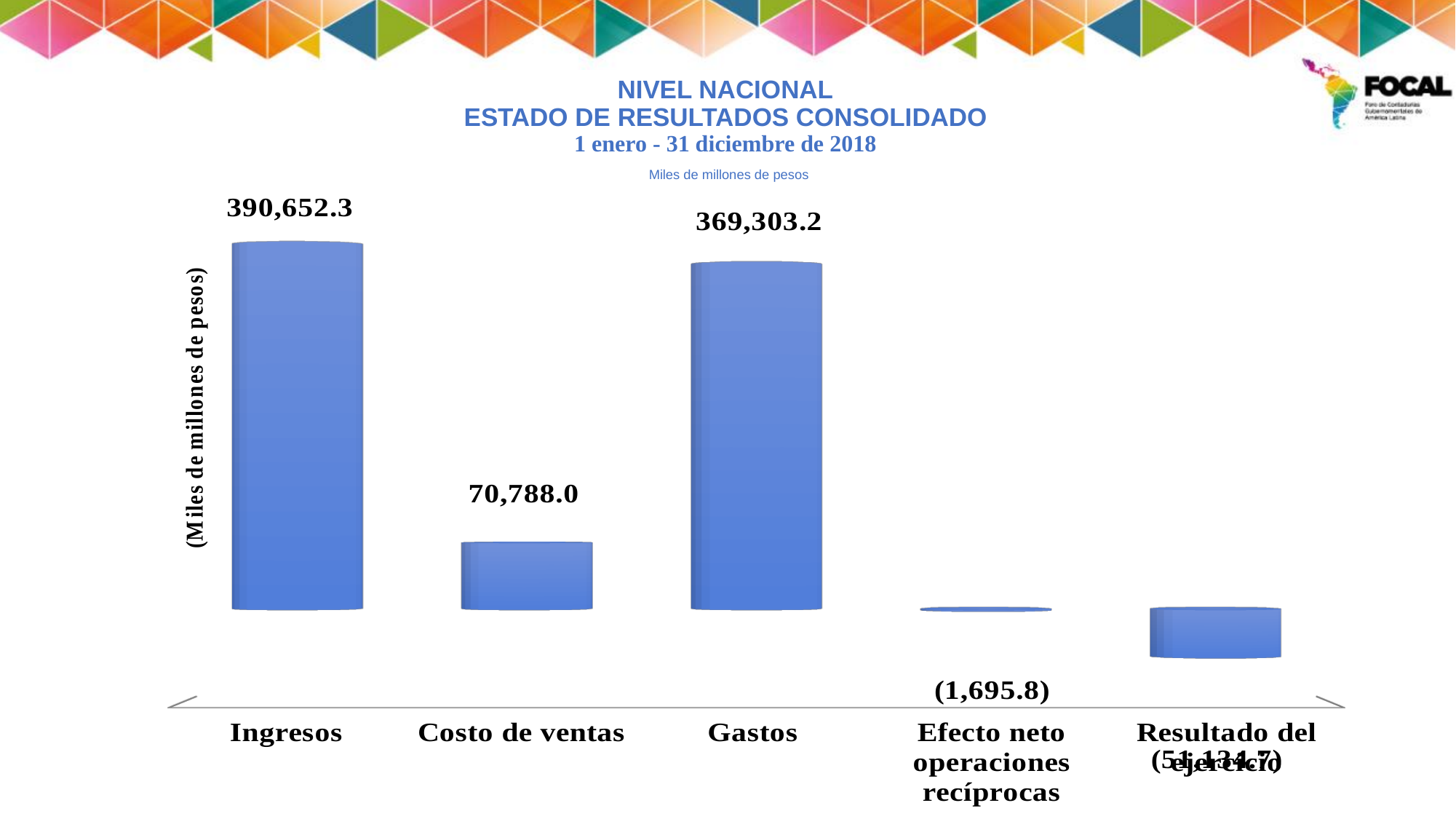
What kind of chart is shown on the slide? Bar chart How many categories are shown on the x axis? 5 Which category has the highest value? Ingresos Which is larger, Gastos or Costo de ventas? Gastos What is the label on the vertical axis? (Miles de millones de pesos) What is the value for Costo de ventas? 70,788.0 What is the difference between Ingresos and Gastos? 21,349.1 Which category has the lowest value? Resultado del ejercicio What is the value for Gastos? 369,303.2 What is the value for Ingresos? 390,652.3 What is the difference between Gastos and Costo de ventas? 298,515.2 What is the value for Efecto neto operaciones recíprocas? (1,695.8)